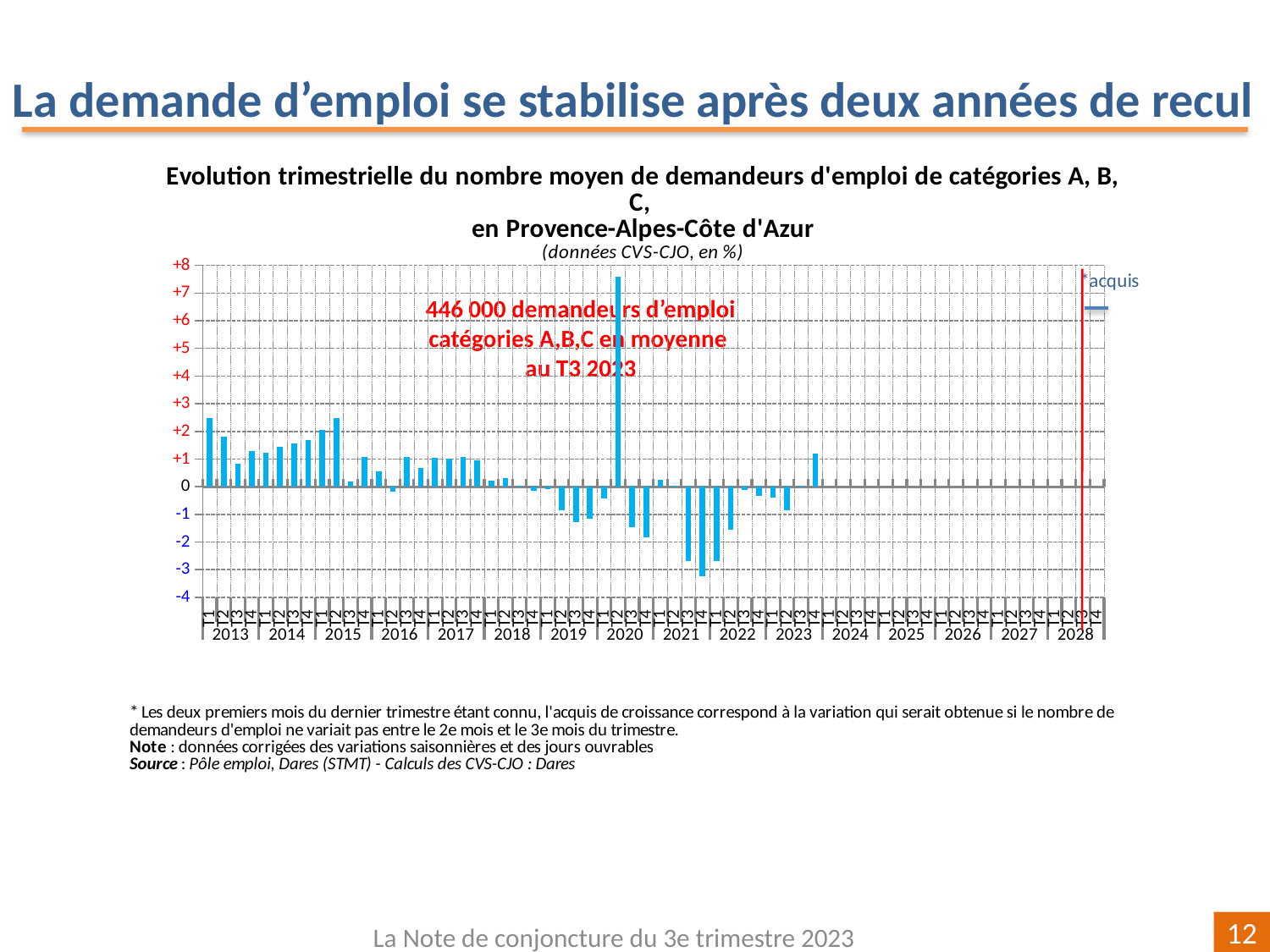
Which quarter has the highest value on the chart? T2 2020 Which quarter has the lowest value on the chart? T4 2021 Is the value for T1 2022 greater or less than -3? greater Which is larger, the value for T1 2013 or the value for T2 2013? T1 2013 What kind of chart is shown on the slide? bar chart How many years are labelled along the x axis of the chart? 16 Is the value for T1 2013 greater or less than +2? greater Is the value for T2 2020 greater or less than +7? greater According to the annotation on the chart, how many demandeurs d'emploi catégories A,B,C were there on average in T3 2023? 446 000 What is the highest value shown on the y axis of the chart? +8